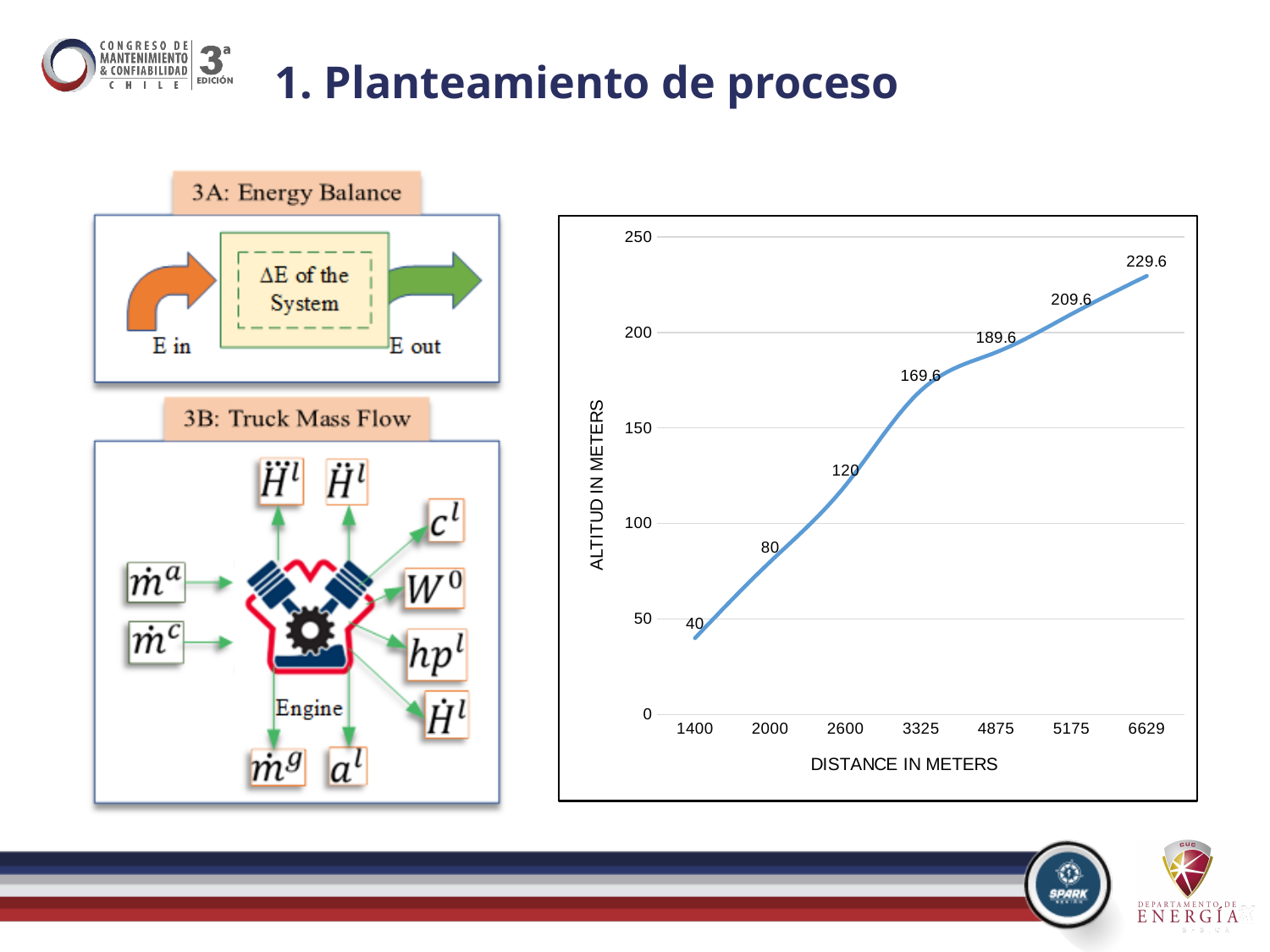
What is the difference in altitude between 4875 meters and 2600 meters? 69.6 How many data points are plotted on the line? 7 What type of chart is shown on the slide? Line chart Does the altitude rise or fall as distance increases along the x axis? Rises What is the altitude at a distance of 3325 meters? 169.6 At which distance is the altitude lowest? 1400 At which distance is the altitude highest? 6629 What is the altitude at a distance of 1400 meters? 40 What is the altitude at a distance of 6629 meters? 229.6 What is the label of the vertical axis of the chart? ALTITUD IN METERS Which has a higher altitude: 2000 meters or 3325 meters? 3325 What is the altitude at a distance of 5175 meters? 209.6